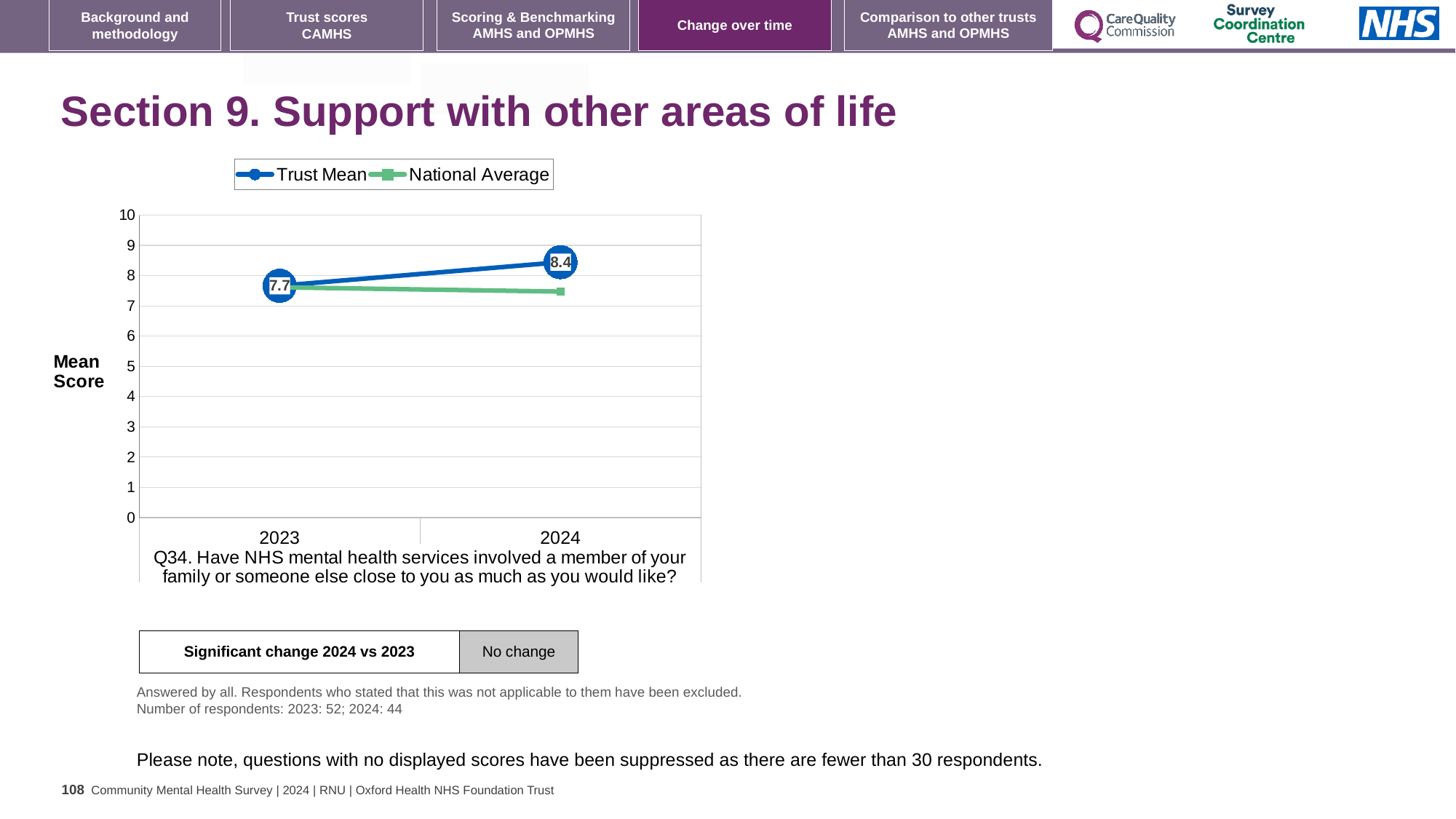
Does the Trust Mean rise or fall from 2023 to 2024? rise What is the Trust Mean score for 2024? 8.4 How many years are shown on the x axis of the chart? 2 Is the Trust Mean for 2024 larger or smaller than the Trust Mean for 2023? larger What kind of chart is shown on the slide? line chart Is the National Average for 2024 greater or less than 8? less By how much did the Trust Mean score change from 2023 to 2024? 0.7 What is the Trust Mean score for 2023? 7.7 Is the National Average for 2023 greater or less than 7? greater In which year is the Trust Mean score lower? 2023 How many series does the legend list? 2 In which year is the Trust Mean score higher? 2024